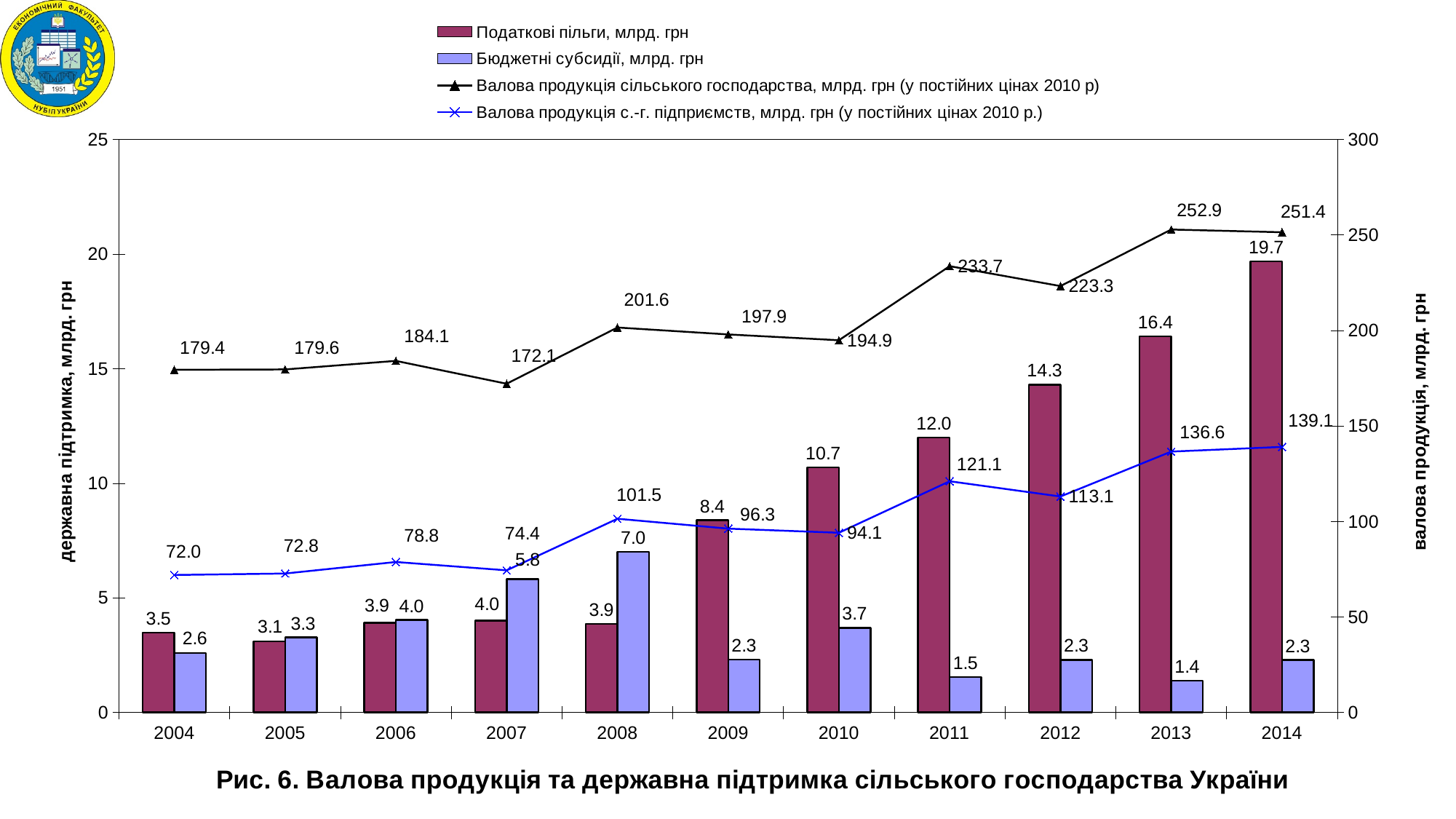
What is the value of Валова продукція сільського господарства (gross agricultural output) in 2013? 252.9 What kind of chart is shown on the slide? Combination bar and line chart What is the value of Податкові пільги (tax benefits) in 2014? 19.7 In which year was Валова продукція сільського господарства (gross agricultural output) the lowest? 2007 In which year were Бюджетні субсидії (budget subsidies) the highest? 2008 Do the values of Податкові пільги (tax benefits) rise or fall from 2009 to 2014? Rise What is the value of Валова продукція с.-г. підприємств (gross output of agricultural enterprises) in 2011? 121.1 In 2007, which was larger: Податкові пільги (tax benefits) or Бюджетні субсидії (budget subsidies)? Бюджетні субсидії By how much did Податкові пільги (tax benefits) increase from 2013 to 2014? 3.3 How many series does the legend list? 4 How many years are shown on the x axis of the chart? 11 What is the value of Бюджетні субсидії (budget subsidies) in 2008? 7.0